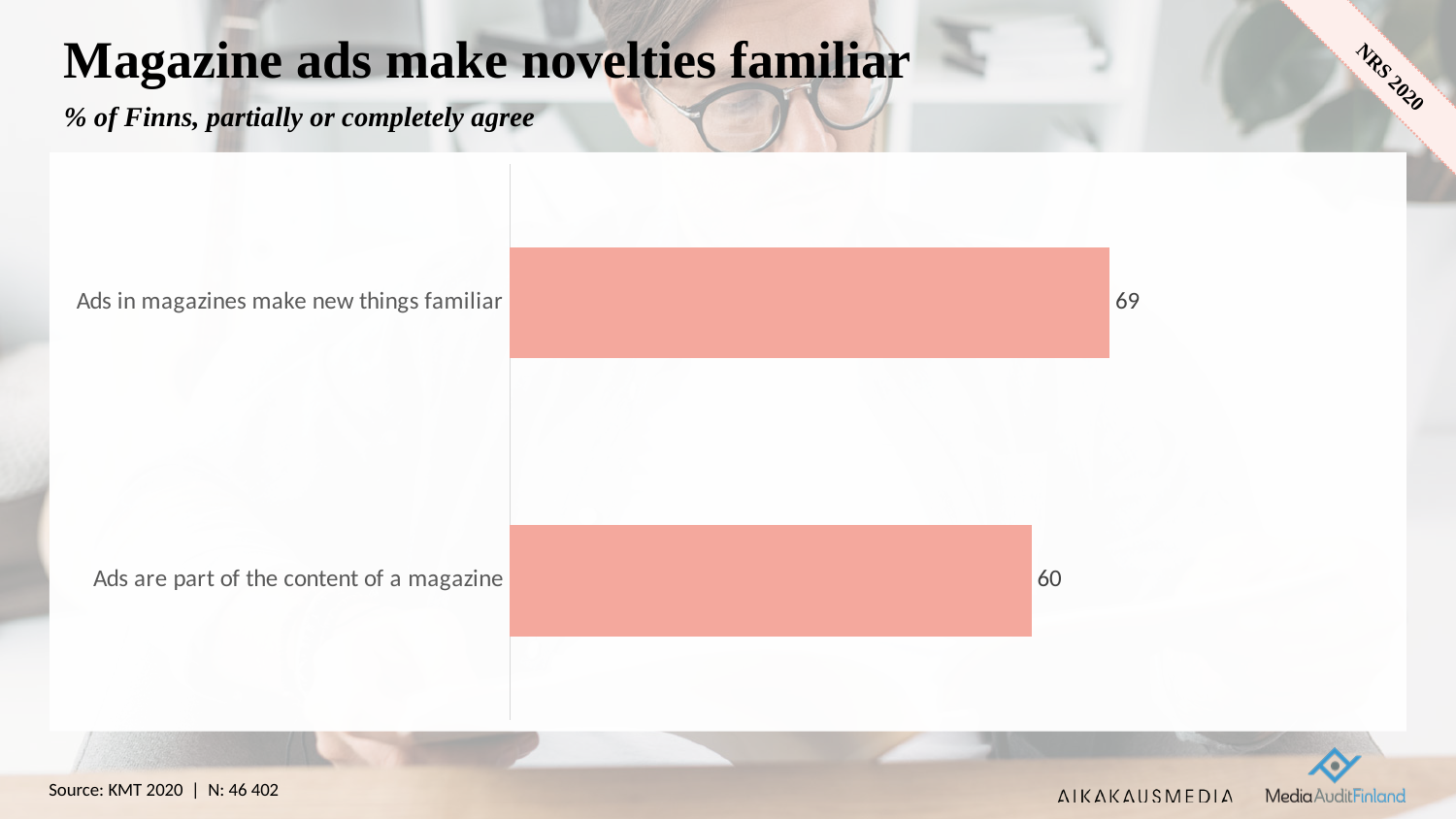
What is the title of the slide containing the chart? Magazine ads make novelties familiar Which category has the highest value? Ads in magazines make new things familiar What is the value for "Ads in magazines make new things familiar"? 69 Which category has the lowest value? Ads are part of the content of a magazine Which is larger: the value for "Ads in magazines make new things familiar" or for "Ads are part of the content of a magazine"? Ads in magazines make new things familiar What is the difference between the values for "Ads in magazines make new things familiar" and "Ads are part of the content of a magazine"? 9 What colour are the bars in the chart? Salmon pink What kind of chart is shown on the slide? Bar chart What is the value for "Ads are part of the content of a magazine"? 60 How many categories are shown in the chart? 2